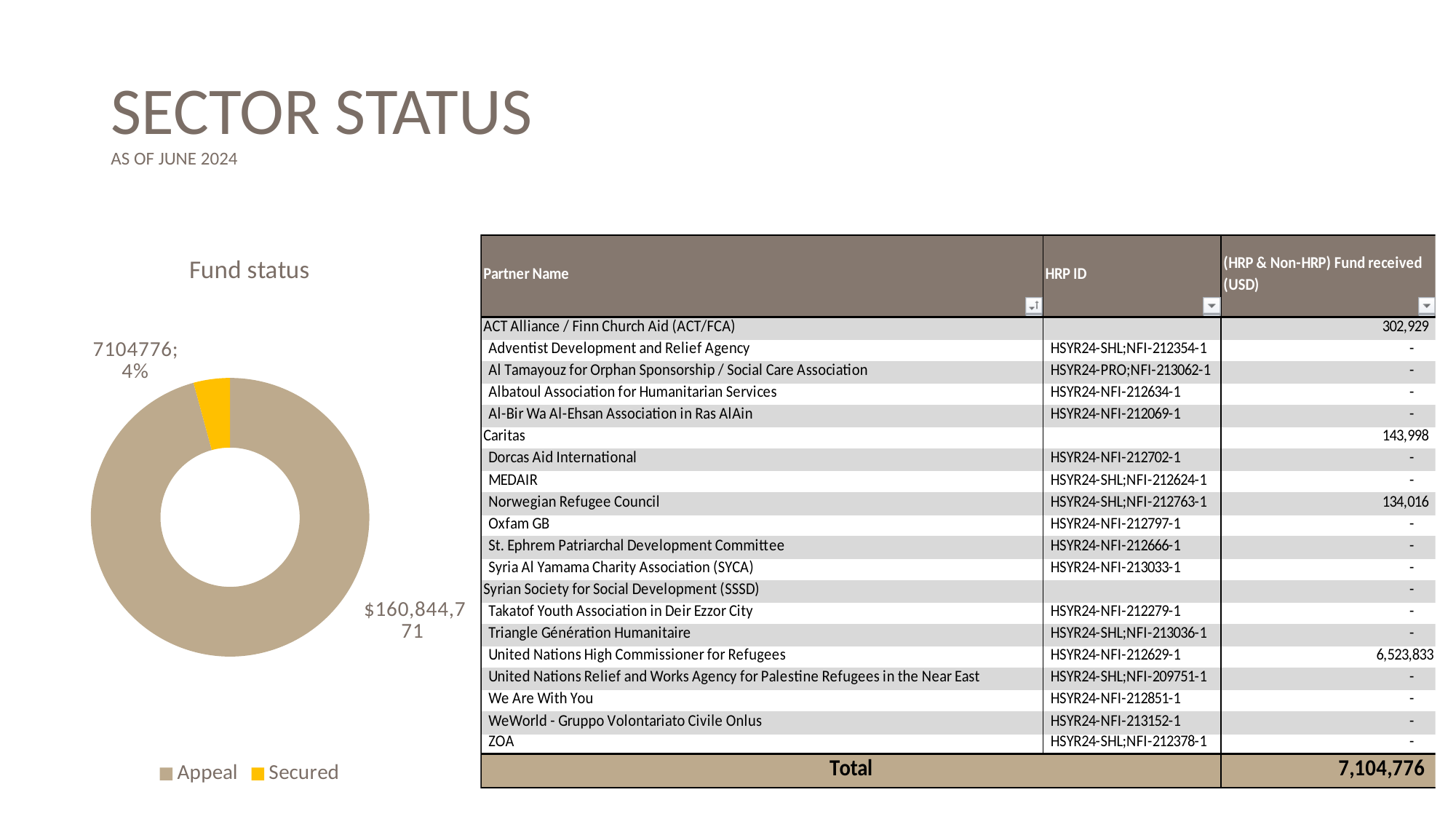
What percentage share does the Secured slice have in the "Fund status" chart? 4% In the "Fund status" chart, which is larger, Appeal or Secured? Appeal How many entries does the legend of the "Fund status" chart list? 2 What value is shown for the Appeal slice in the "Fund status" chart? $160,844,771 In the "Fund status" chart, what is the difference between the Appeal value and the Secured value? 153,739,995 What value is shown for the Secured slice in the "Fund status" chart? 7104776 What is the title of the chart on the left of the slide? Fund status What kind of chart is the "Fund status" chart? doughnut (pie) chart How many slices does the "Fund status" chart have? 2 Which slice is the smallest in the "Fund status" chart? Secured Which slice is the largest in the "Fund status" chart? Appeal What colour is the Secured slice in the "Fund status" chart? yellow